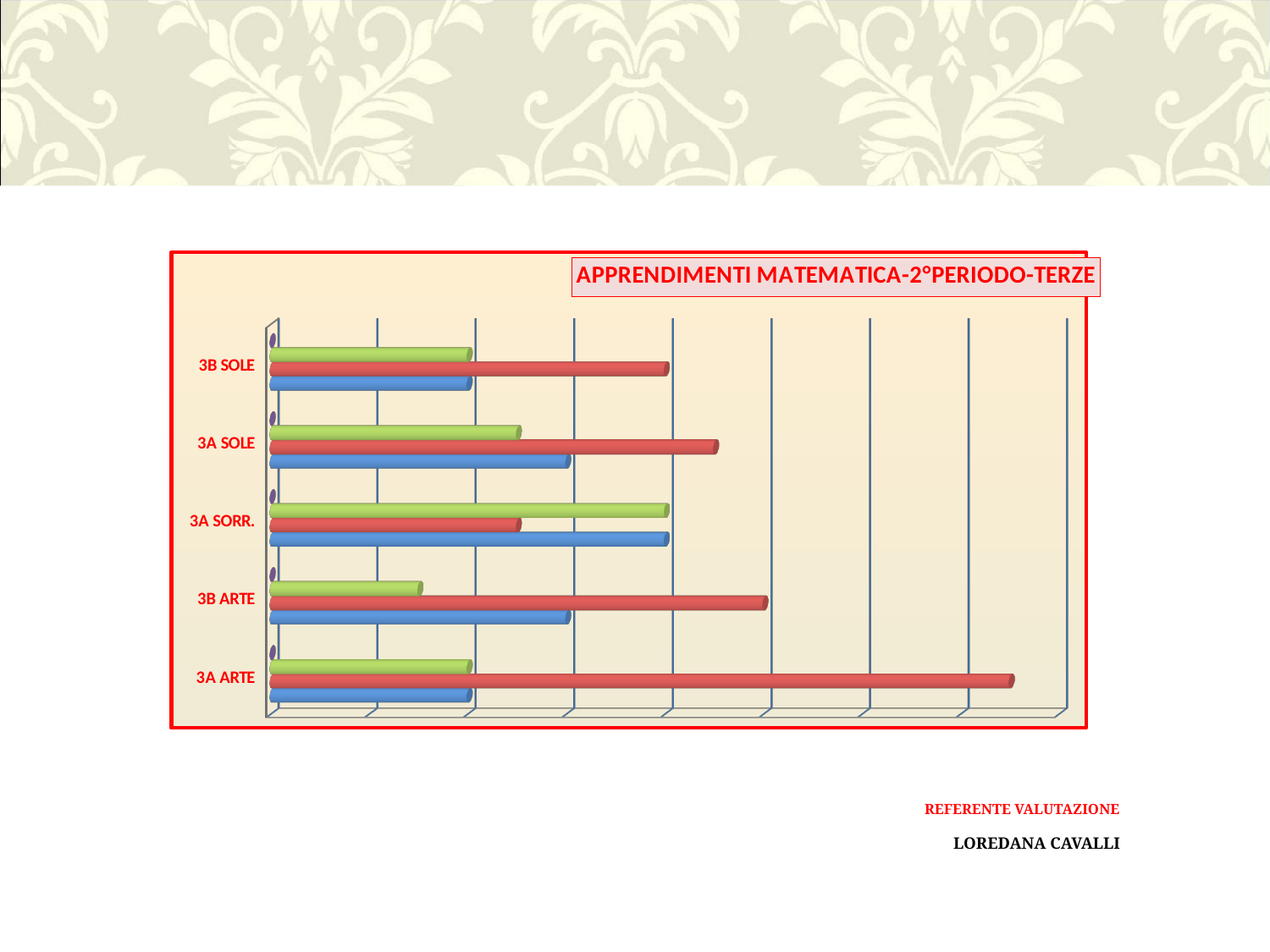
What is the title of the chart? APPRENDIMENTI MATEMATICA-2°PERIODO-TERZE Which class has the longest blue bar in the chart? 3A SORR. Which class is listed at the top of the vertical axis in the chart? 3B SOLE Which class has the longest red bar in the chart? 3A ARTE For 3A SORR., is the green bar or the red bar longer? green Which class has the shortest green bar in the chart? 3B ARTE How many bars are plotted for each class in the chart? 3 How many categories (classes) are shown on the vertical axis of the chart? 5 Which class has the shortest red bar in the chart? 3A SORR. What kind of chart is shown on the slide? bar chart For 3B ARTE, is the red bar or the blue bar longer? red Is the red bar for 3A ARTE longer or shorter than the red bar for 3B ARTE? longer